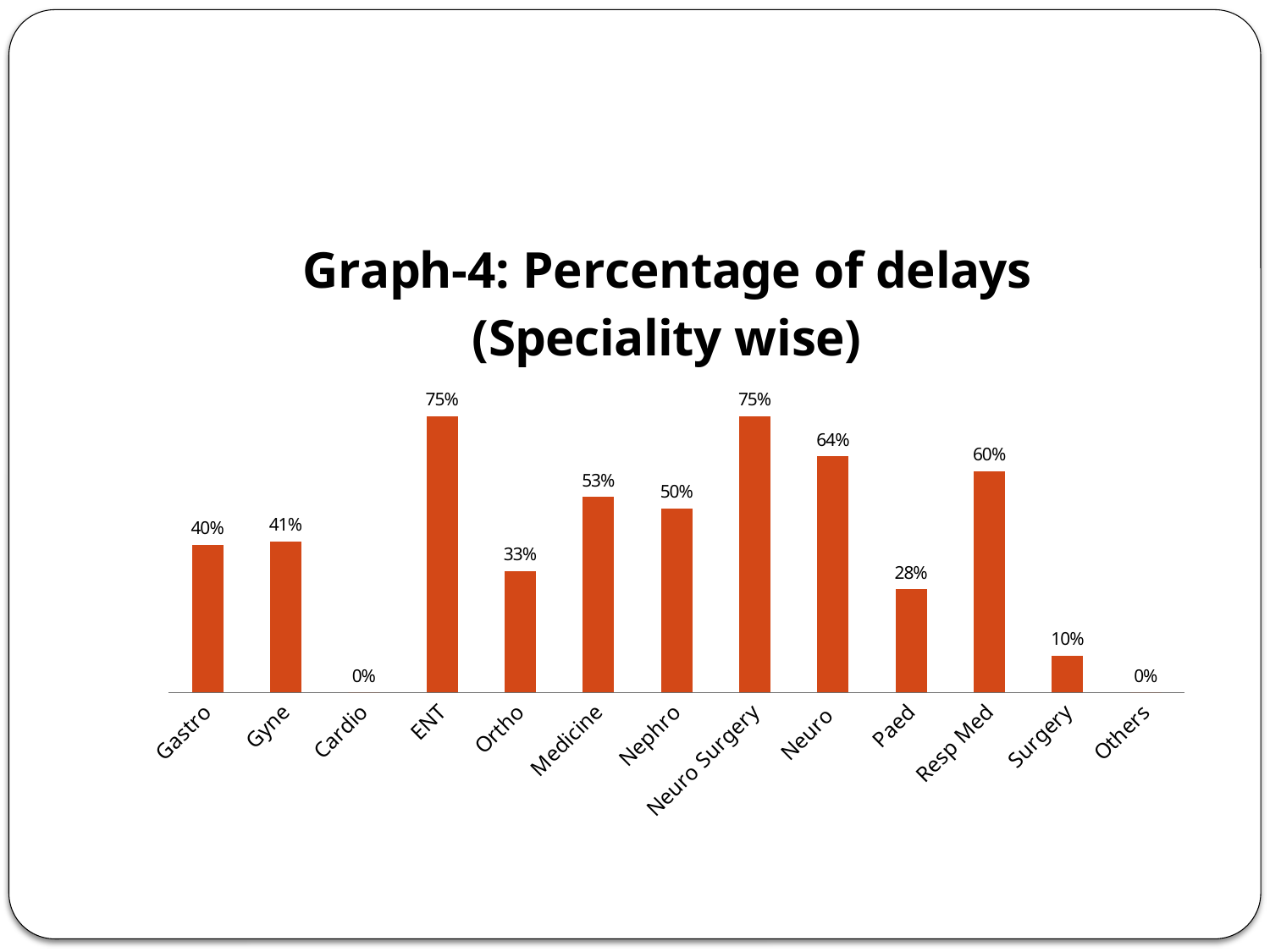
What is the percentage of delays for Paed? 28% Which two specialities share the highest percentage of delays? ENT and Neuro Surgery Which has a higher percentage of delays, Gastro or Resp Med? Resp Med What kind of chart is shown on the slide? Bar chart How many specialities are shown on the x axis? 13 What is the percentage of delays for ENT? 75% What is the title of the chart? Graph-4: Percentage of delays (Speciality wise) What is the difference between the percentage of delays for Medicine and for Nephro? 3% Which two specialities show 0% delays? Cardio and Others What is the percentage of delays for Surgery? 10% What is the difference between the percentage of delays for Neuro and for Ortho? 31% What is the percentage of delays for Resp Med? 60%